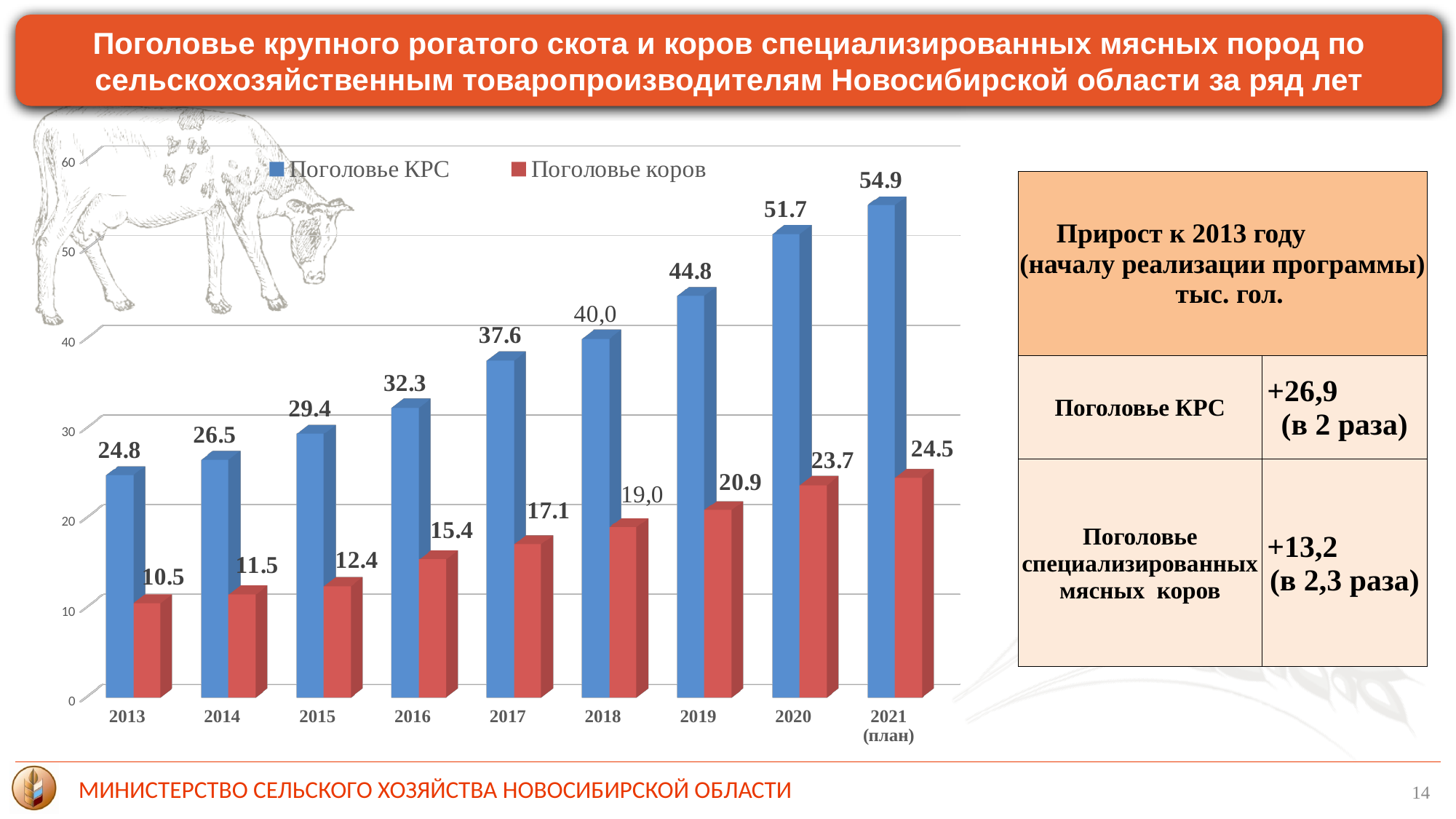
How many series does the chart legend list? 2 What is the value for Поголовье КРС in 2013? 24.8 What is the difference between Поголовье КРС and Поголовье коров in 2020? 28.0 How many years are shown on the x axis of the chart? 9 What is the value for Поголовье коров in 2018? 19,0 Do the values for Поголовье КРС rise or fall from 2013 to 2021 (план)? rise Which year has the highest value for Поголовье КРС? 2021 (план) Is the value for Поголовье КРС in 2017 greater or less than 30? greater Which year has the lowest value for Поголовье коров? 2013 What kind of chart is shown on the slide? bar chart Which is larger: Поголовье коров in 2019 or Поголовье коров in 2016? Поголовье коров in 2019 What is the value for Поголовье КРС in 2021 (план)? 54.9